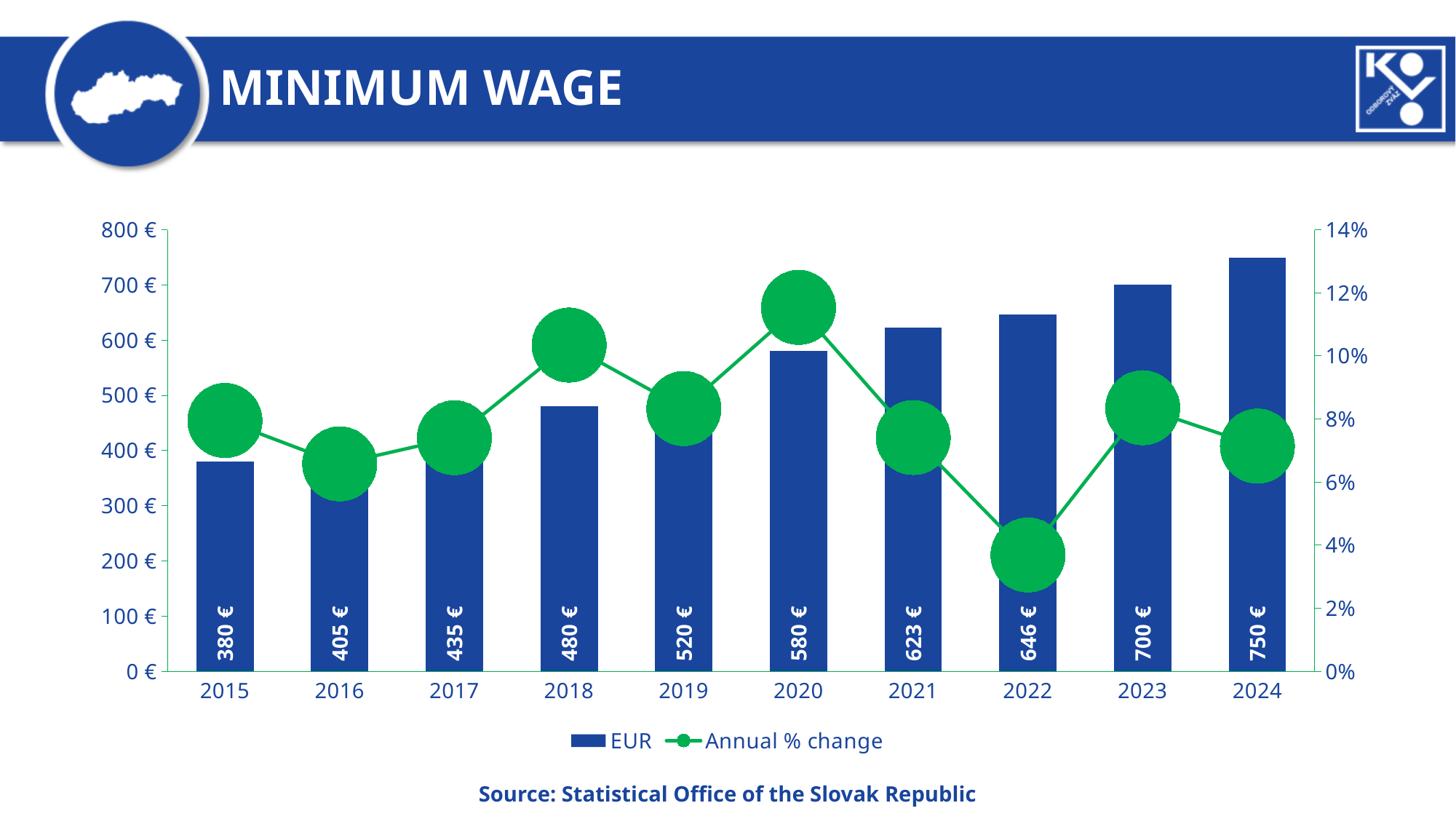
Which year has the highest minimum wage bar? 2024 How many series does the legend list? 2 Is the annual % change for 2022 greater or less than 6%? less What is the minimum wage value shown for 2017? 435 € What is the difference between the minimum wage in 2024 and in 2015? 370 € How many years are shown on the x axis? 10 Which year has the higher annual % change point, 2020 or 2022? 2020 What is the difference between the minimum wage in 2023 and in 2022? 54 € Is the annual % change for 2020 greater or less than 10%? greater Which year has the lowest minimum wage bar? 2015 Do the minimum wage bars rise or fall from 2015 to 2024? rise What is the minimum wage value shown for 2020? 580 €